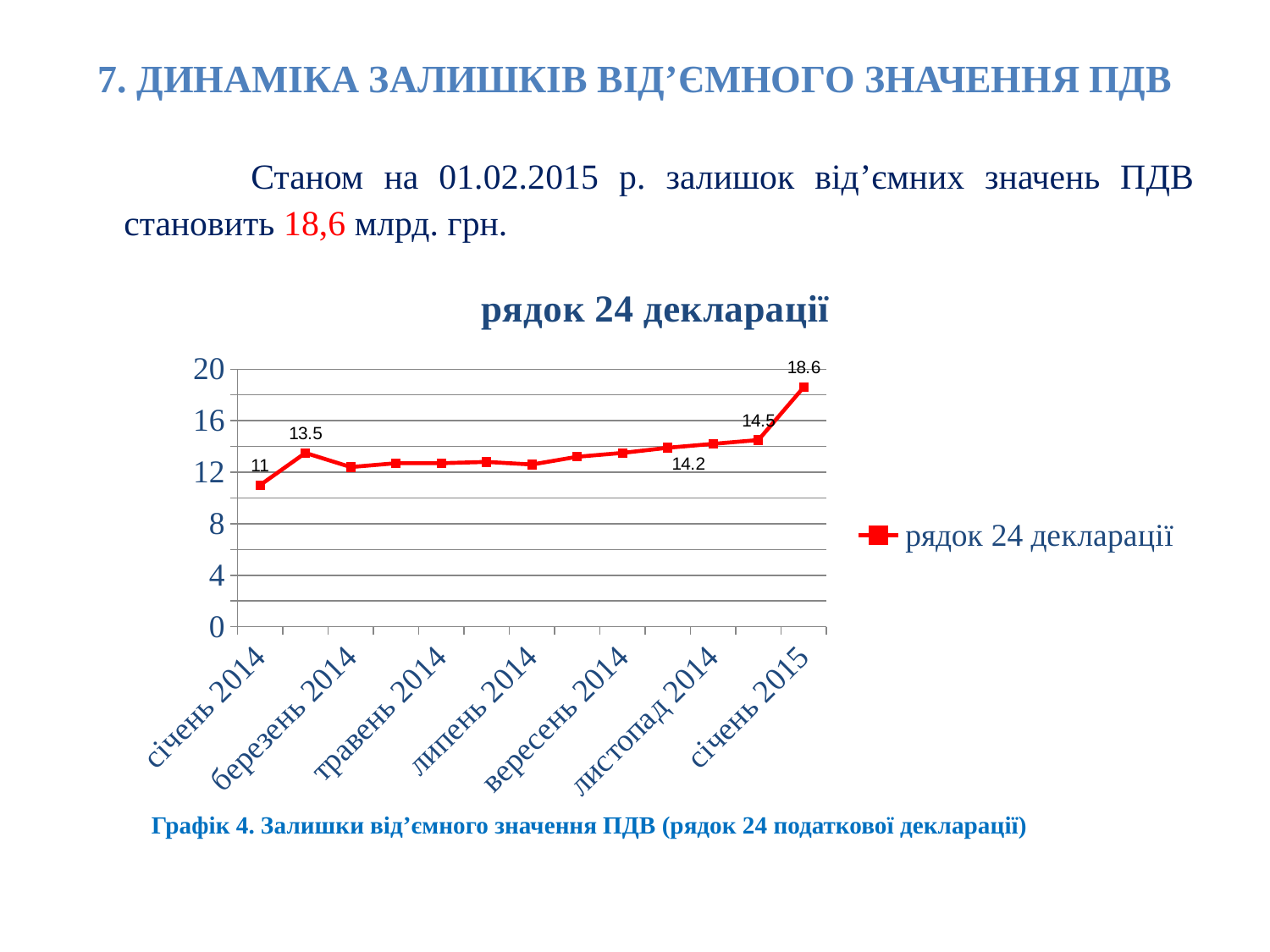
What is the value for січень 2015? 18.6 Which month has the lowest value? січень 2014 How many data points are plotted on the line? 13 Is the value for травень 2014 greater or less than 12? greater What is the difference between the values for січень 2015 and січень 2014? 7.6 What kind of chart is shown on the slide? line chart Do the values generally rise or fall from січень 2014 to січень 2015? rise What is the value for січень 2014? 11 Is the value for листопад 2014 greater or less than 16? less Which is larger, the value for січень 2015 or the value for січень 2014? січень 2015 Which month has the highest value? січень 2015 How many series does the legend list? 1